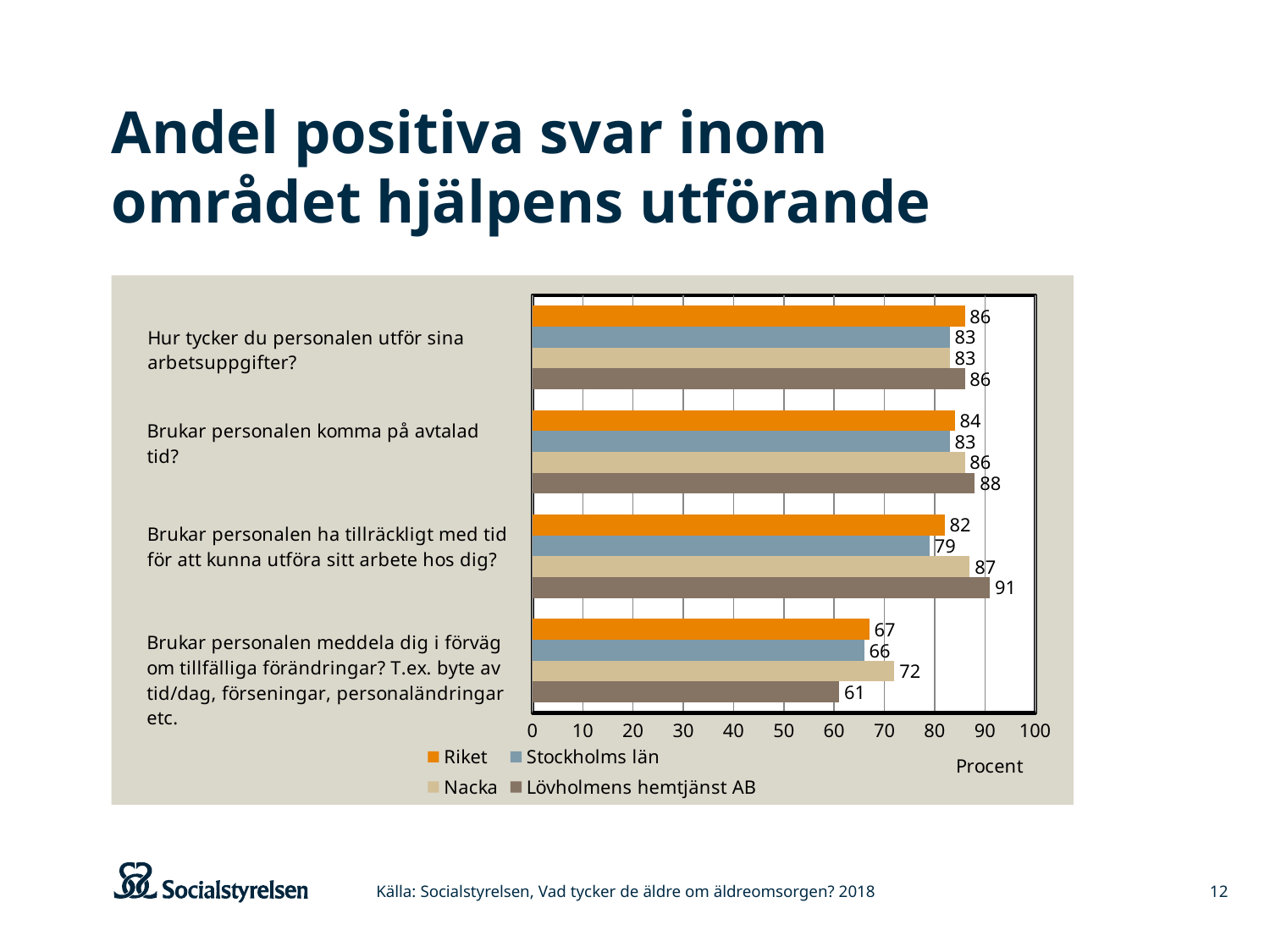
Which is larger on "Brukar personalen komma på avtalad tid?": Nacka or Riket? Nacka Which series has the lowest value on "Brukar personalen meddela dig i förväg om tillfälliga förändringar?"? Lövholmens hemtjänst AB What is the value for Stockholms län on "Hur tycker du personalen utför sina arbetsuppgifter?"? 83 What is the value for Nacka on "Brukar personalen meddela dig i förväg om tillfälliga förändringar?"? 72 What is the value for Lövholmens hemtjänst AB on "Brukar personalen ha tillräckligt med tid för att kunna utföra sitt arbete hos dig?"? 91 What is the difference between Nacka and Stockholms län on "Brukar personalen ha tillräckligt med tid för att kunna utföra sitt arbete hos dig?"? 8 How many series does the legend list? 4 Which series has the highest value on "Brukar personalen ha tillräckligt med tid för att kunna utföra sitt arbete hos dig?"? Lövholmens hemtjänst AB What kind of chart is shown on the slide? Bar chart How many question categories are shown on the chart? 4 What is the value for Riket on "Brukar personalen komma på avtalad tid?"? 84 Is the value for Riket on "Brukar personalen meddela dig i förväg om tillfälliga förändringar?" greater or less than 70? less